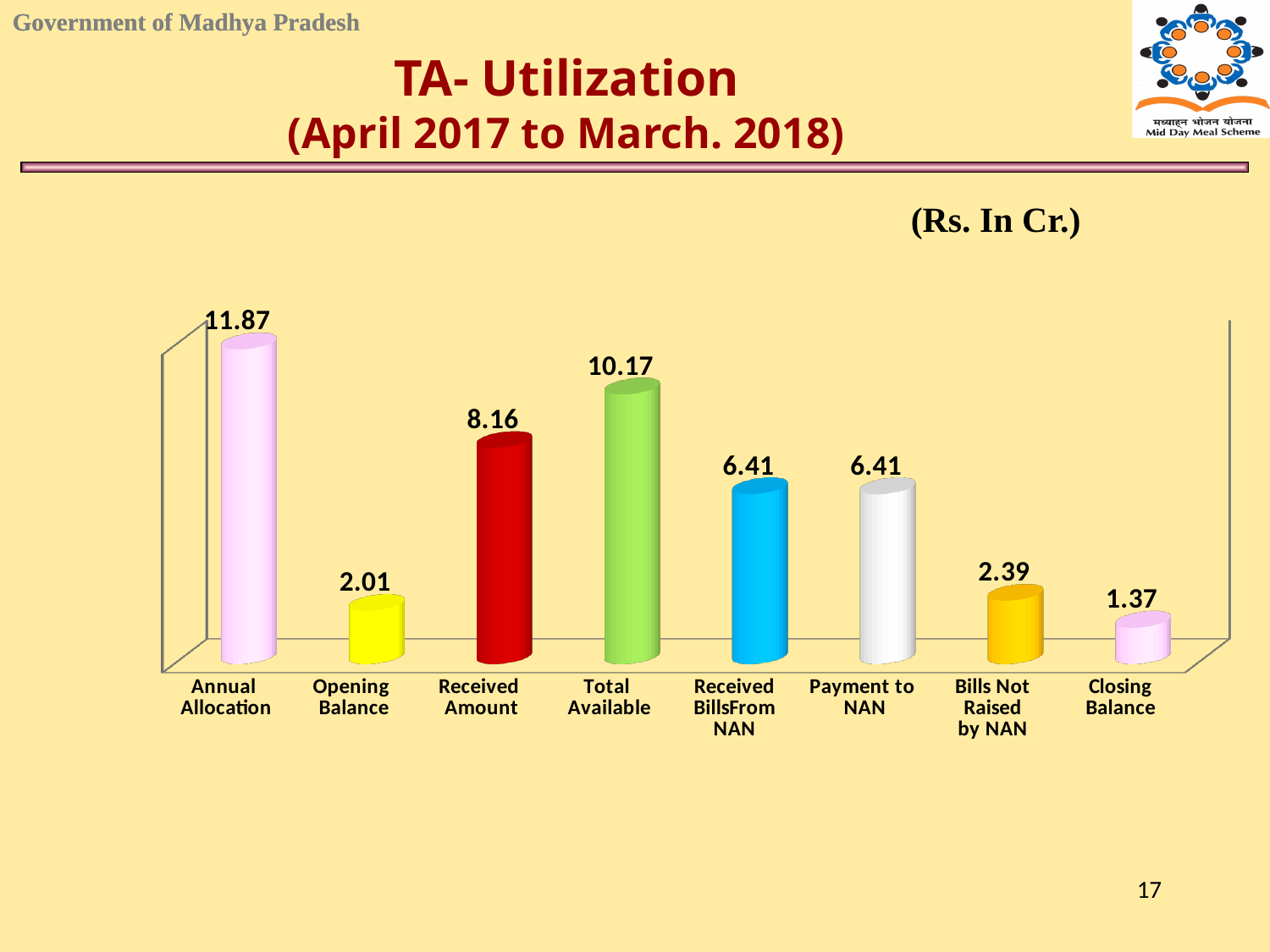
What is the value for Annual Allocation? 11.87 How many categories are shown in the chart? 8 What is the value for Opening Balance? 2.01 What is the difference between Total Available and Received Amount? 2.01 What kind of chart is shown on the slide? Bar chart What is the value for Closing Balance? 1.37 Which is larger, Received Amount or Payment to NAN? Received Amount Which category has the highest value? Annual Allocation What is the difference between Annual Allocation and Total Available? 1.70 Which category has the lowest value? Closing Balance What unit is stated for the values in the chart? Rs. In Cr. What is the value for Bills Not Raised by NAN? 2.39